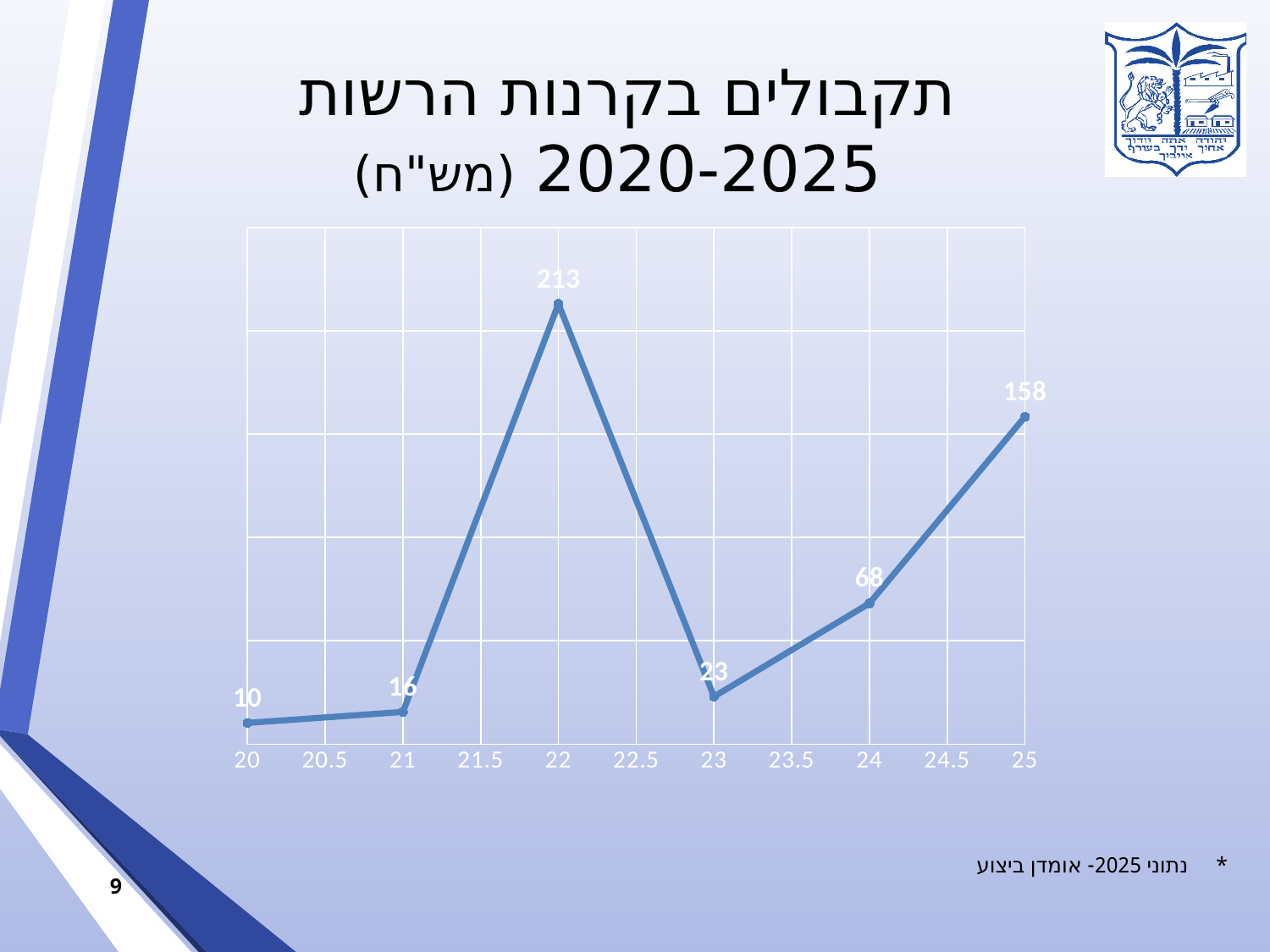
What kind of chart is shown on the slide? Line chart What is the value plotted at x = 24? 68 What is the value plotted at x = 20? 10 Do the values rise or fall from x = 23 to x = 25? Rise At which x value is the plotted value highest? 22 What is the value plotted at x = 22? 213 At which x value is the plotted value lowest? 20 What is the difference between the values at x = 22 and x = 23? 190 How many data points are plotted on the line? 6 What is the value plotted at x = 25? 158 Which is larger, the value at x = 21 or the value at x = 23? 23 (at x = 23) What is the difference between the values at x = 25 and x = 24? 90